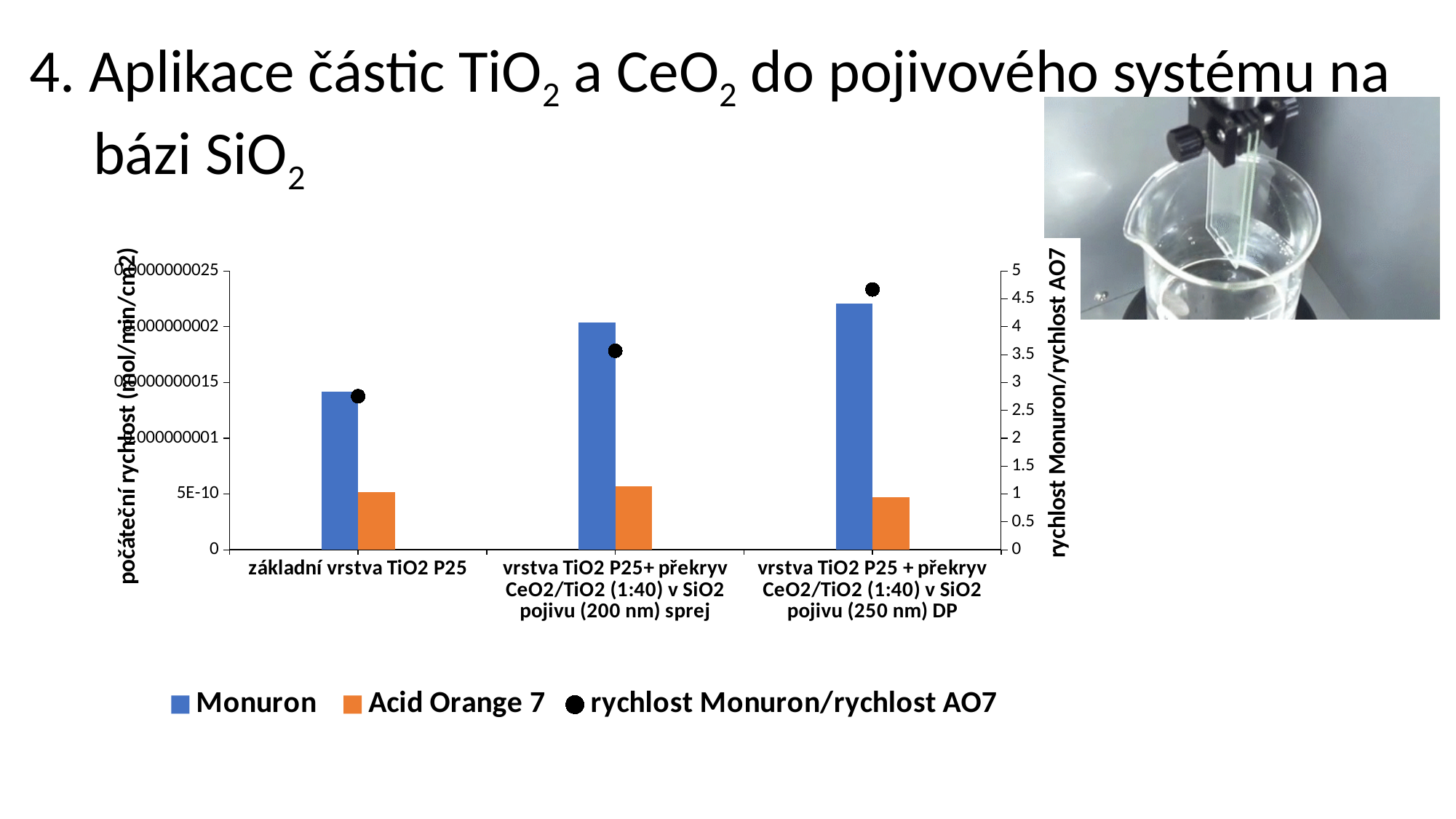
How many series does the chart's legend list? 3 Which category has the highest Monuron value? vrstva TiO2 P25 + překryv CeO2/TiO2 (1:40) v SiO2 pojivu (250 nm) DP What is the title of the right-hand (secondary) vertical axis? rychlost Monuron/rychlost AO7 Is the rychlost Monuron/rychlost AO7 value for vrstva TiO2 P25+ překryv CeO2/TiO2 (1:40) v SiO2 pojivu (200 nm) sprej greater or less than 3? greater Do the Monuron values rise or fall from left to right across the categories? rise Which category has the highest rychlost Monuron/rychlost AO7 value? vrstva TiO2 P25 + překryv CeO2/TiO2 (1:40) v SiO2 pojivu (250 nm) DP How many categories are shown on the x axis of the chart? 3 Is the Monuron value for základní vrstva TiO2 P25 greater or less than 0.0000000015? less Which category has the lowest Acid Orange 7 value? vrstva TiO2 P25 + překryv CeO2/TiO2 (1:40) v SiO2 pojivu (250 nm) DP What kind of chart is shown on the slide? bar chart Which category has the lowest Monuron value? základní vrstva TiO2 P25 Is the Monuron value for vrstva TiO2 P25 + překryv CeO2/TiO2 (1:40) v SiO2 pojivu (250 nm) DP greater or less than 0.000000002? greater